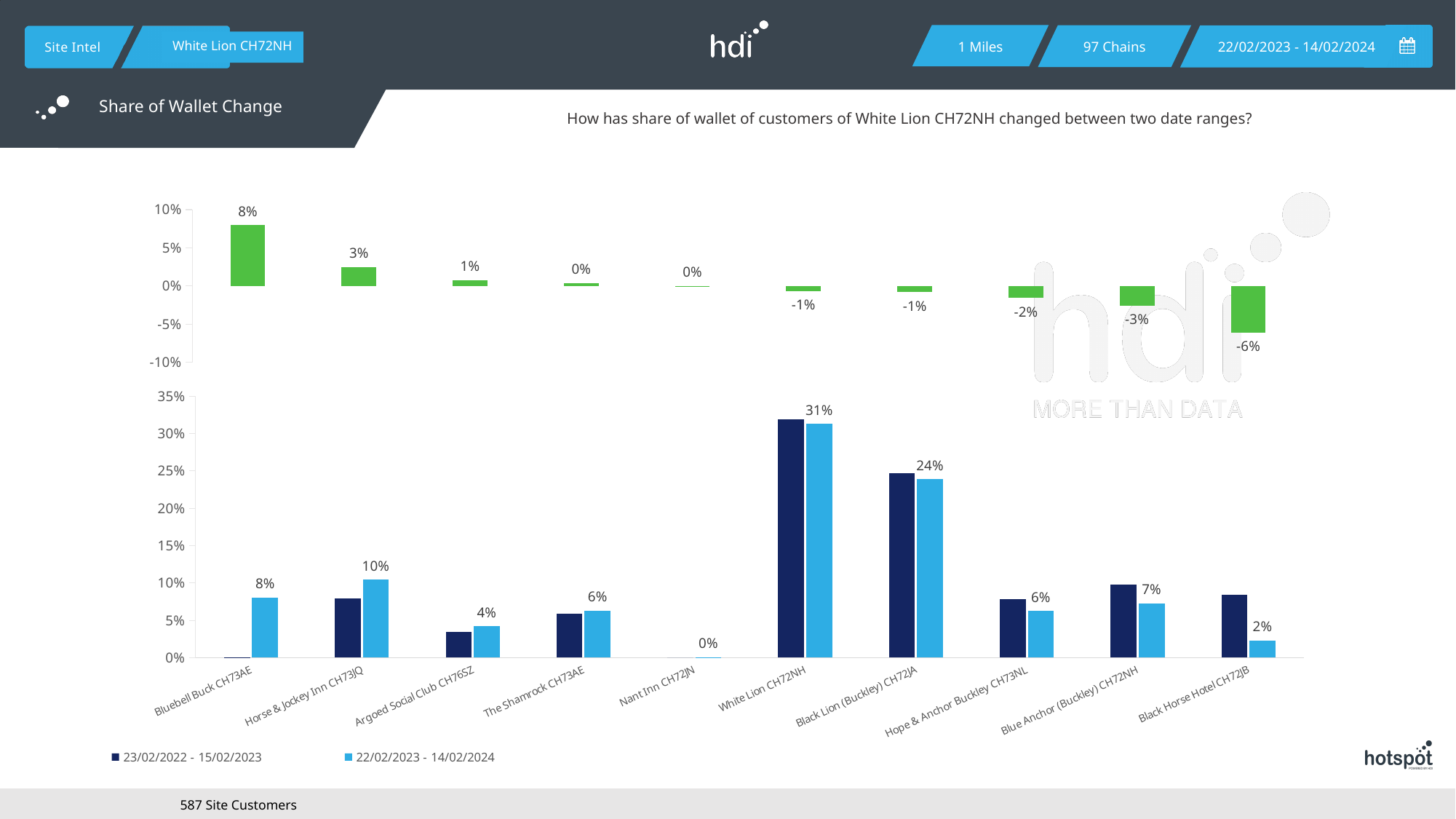
In the bottom chart, is the value for White Lion CH72NH in the 23/02/2022 - 15/02/2023 series greater or less than 30%? greater In the bottom chart, what is the value for Black Lion (Buckley) CH72JA in the 22/02/2023 - 14/02/2024 series? 24% How many categories are shown on the x axis of the bottom chart? 10 In the bottom chart, which category has the highest value in the 22/02/2023 - 14/02/2024 series? White Lion CH72NH In the bottom chart, is the value for Horse & Jockey Inn CH73JQ in the 22/02/2023 - 14/02/2024 series larger than the value for Argoed Social Club CH76SZ in the same series? Yes In the top chart (share of wallet change), what is the value for Black Horse Hotel CH72JB? -6% How many series does the legend of the bottom chart list? 2 In the top chart (share of wallet change), what is the difference between the values for Bluebell Buck CH73AE and Horse & Jockey Inn CH73JQ? 5% In the top chart (share of wallet change), which category has the lowest value? Black Horse Hotel CH72JB In the bottom chart, what is the value for White Lion CH72NH in the 22/02/2023 - 14/02/2024 series? 31% In the top chart (share of wallet change), what is the value for Bluebell Buck CH73AE? 8% In the top chart (share of wallet change), which category has the highest value? Bluebell Buck CH73AE